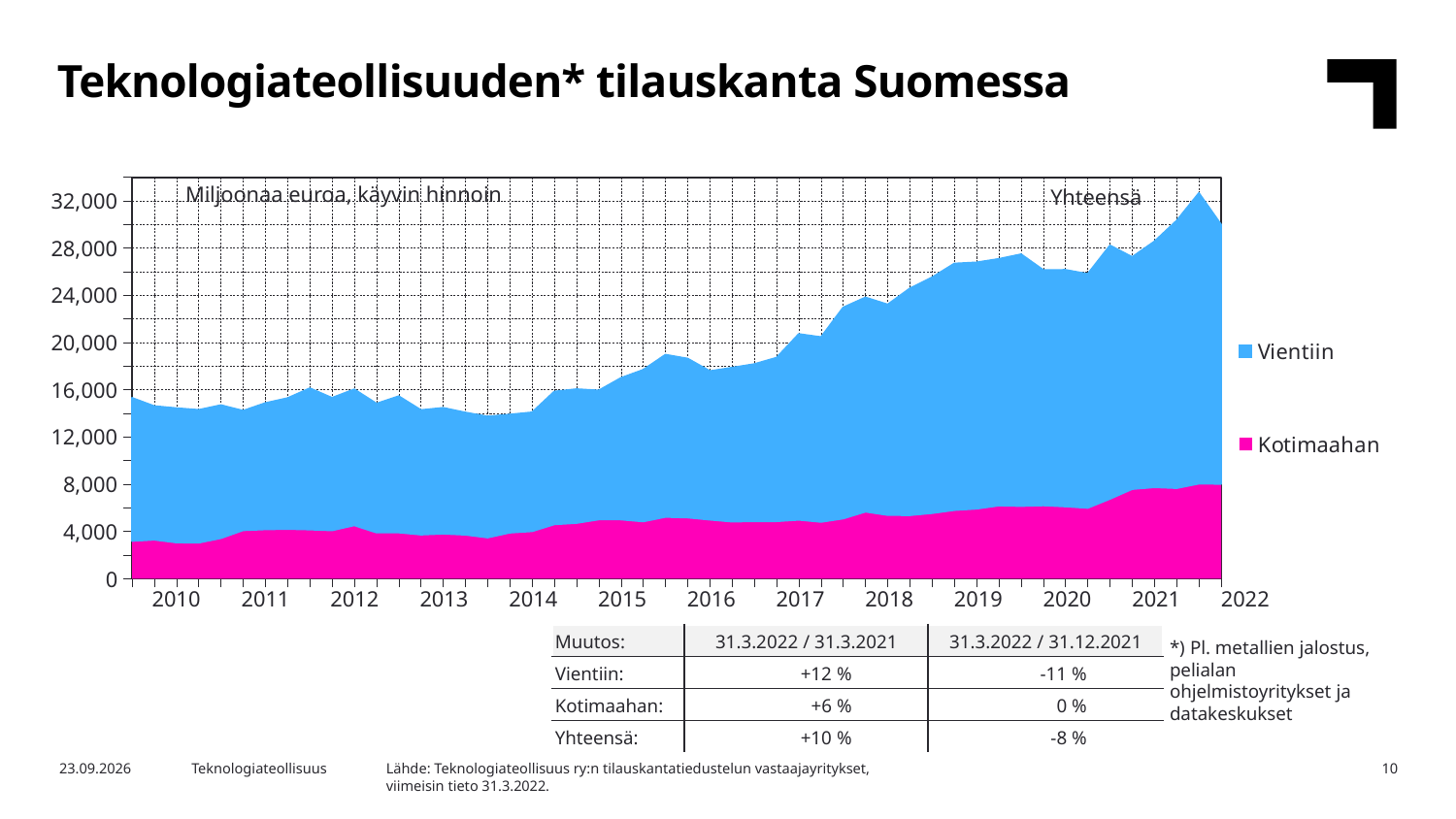
Is the total (Yhteensä) value at the start of 2016 greater or less than 20,000? less Does the total (Yhteensä) order book generally rise or fall from 2010 to 2022? rise Is the total (Yhteensä) value at the start of 2010 greater or less than 16,000? less Is the Kotimaahan value at the start of 2018 greater or less than 4,000? greater How many series does the chart legend list? 2 Which two series are listed in the chart legend? Vientiin and Kotimaahan How many year labels are shown on the x axis? 13 What unit is stated in the chart's axis label text? Miljoonaa euroa, käyvin hinnoin Which series is larger at the start of 2021, Vientiin or Kotimaahan? Vientiin What kind of chart is shown on the slide? Stacked area chart